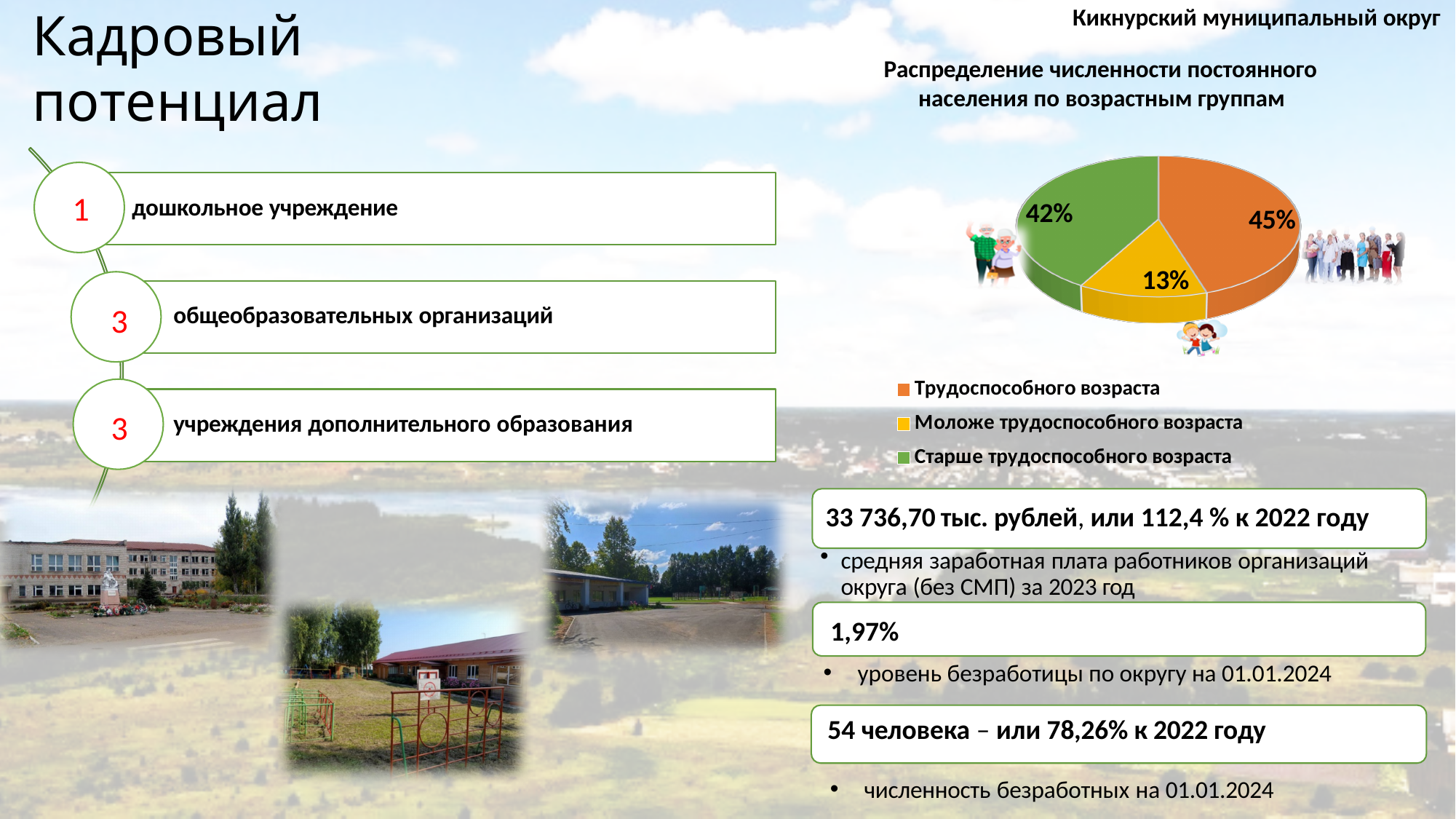
What is the difference in percentage points between the working-age share and the younger-than-working-age share? 32 What share of the population is of working age (Трудоспособного возраста)? 45% Which age group has the largest share of the population? Трудоспособного возраста Which age group has the smallest share of the population? Моложе трудоспособного возраста What share of the population is older than working age (Старше трудоспособного возраста)? 42% What is the title of the pie chart? Распределение численности постоянного населения по возрастным группам What is the difference in percentage points between the working-age share and the older-than-working-age share? 3 What share of the population is younger than working age (Моложе трудоспособного возраста)? 13% How many age groups are shown in the pie chart? 3 Which is larger: the share older than working age or the share younger than working age? Старше трудоспособного возраста What type of chart is shown on the slide? pie chart What colour represents the group younger than working age in the pie chart? yellow